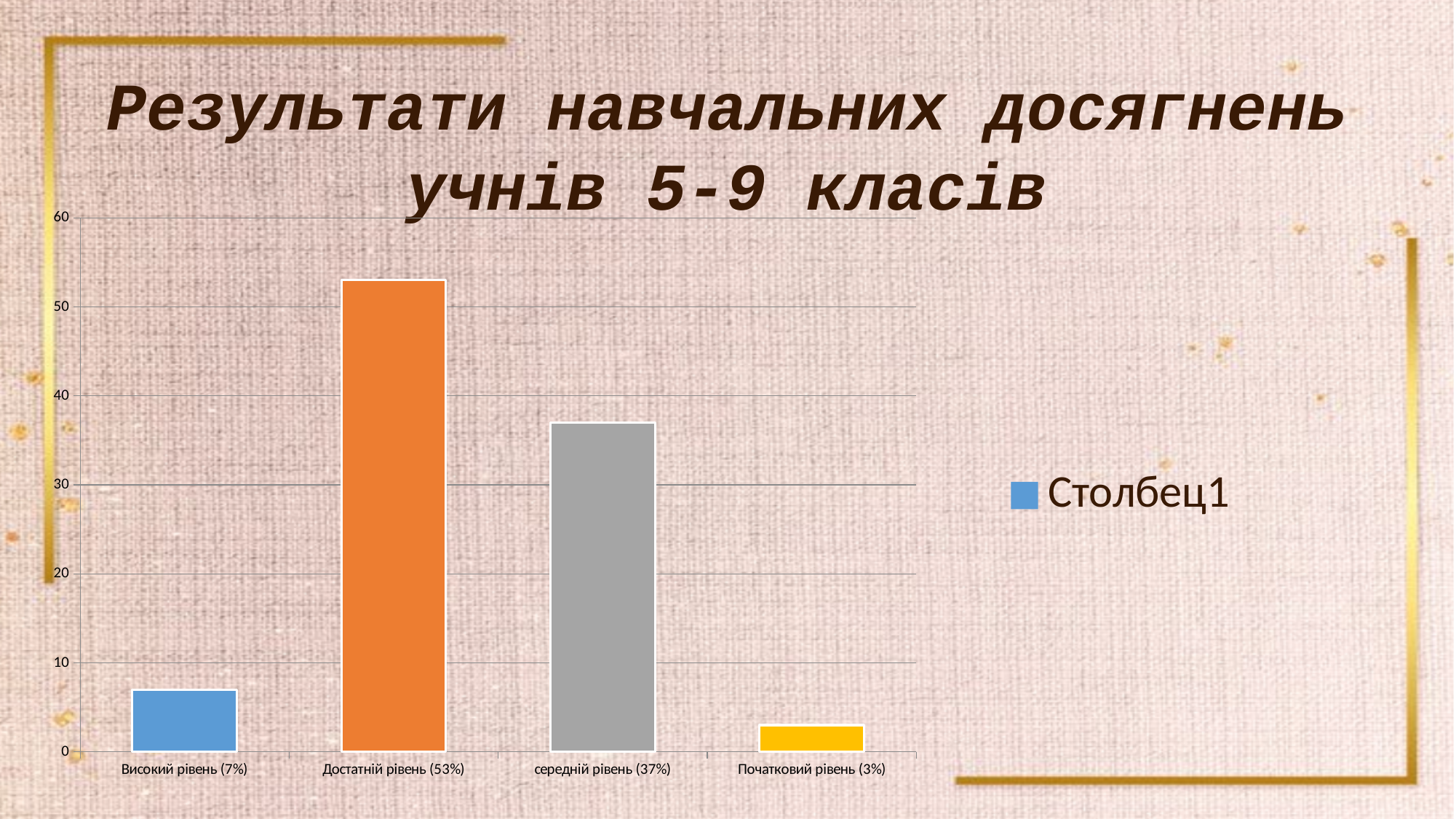
What kind of chart is shown on the slide? bar chart Is the value for середній рівень greater or less than 40? less What percentage is shown for Початковий рівень? 3% What is the name of the series shown in the chart legend? Столбец1 Which is larger, the value for Високий рівень or the value for середній рівень? середній рівень How many series does the chart legend list? 1 What is the difference between the values for Достатній рівень and середній рівень? 16% What percentage is shown for Високий рівень? 7% What percentage is shown for Достатній рівень? 53% Which category has the lowest bar? Початковий рівень (3%) How many categories are shown on the x axis of the chart? 4 Which category has the highest bar? Достатній рівень (53%)